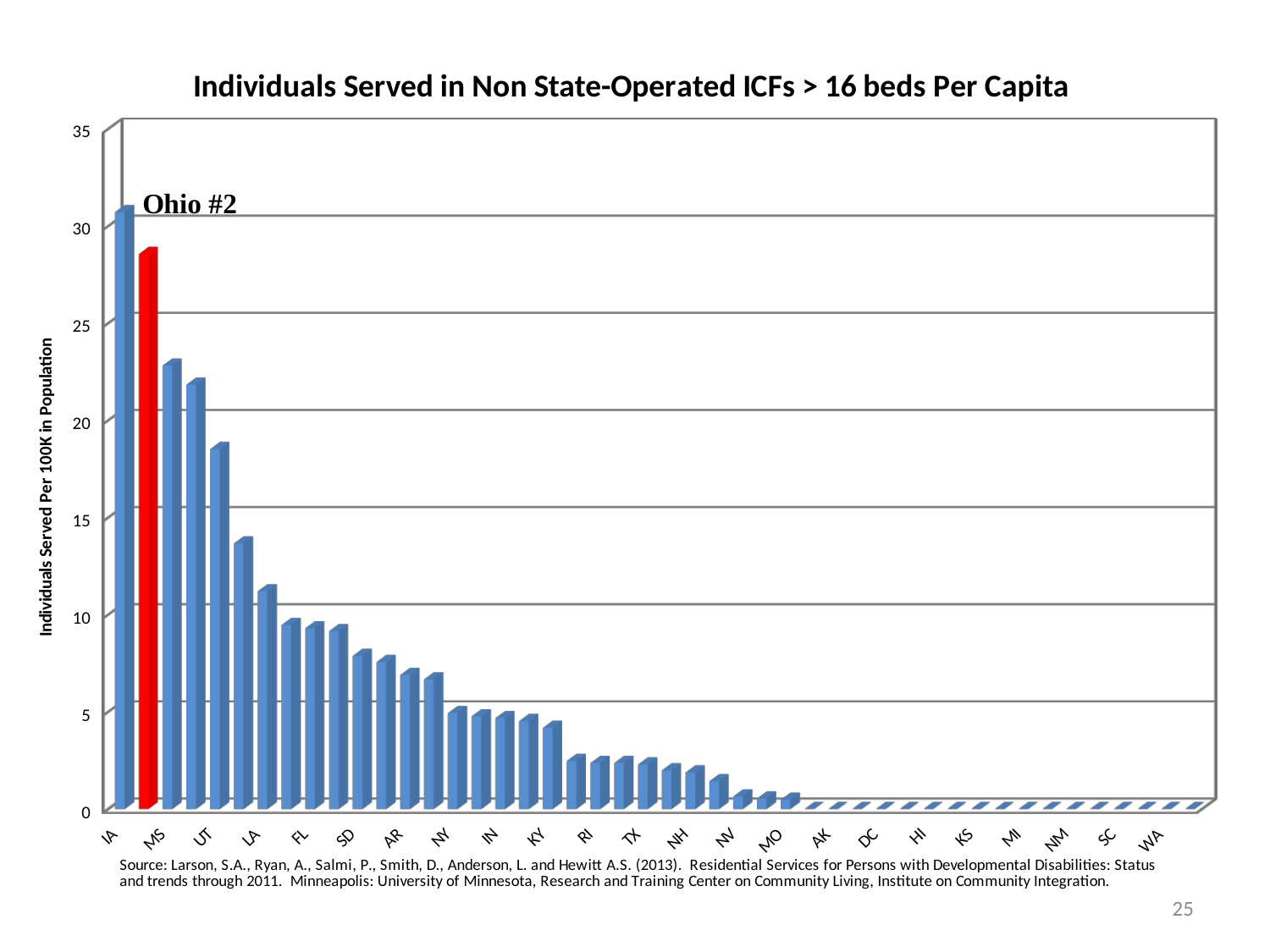
What colour is the bar for Ohio? red Is the value for Ohio greater or less than 25? greater What kind of chart is shown on the slide? bar chart Is the value for Ohio greater or less than 30? less Is the value for IA greater or less than 30? greater What is the highest value shown on the y axis? 35 How many state labels are shown along the x axis? 23 Which state has the highest value in the chart? IA Do the values rise or fall moving from left to right along the x axis? fall Which has a larger value, IA or Ohio? IA What rank does the chart annotation give Ohio? #2